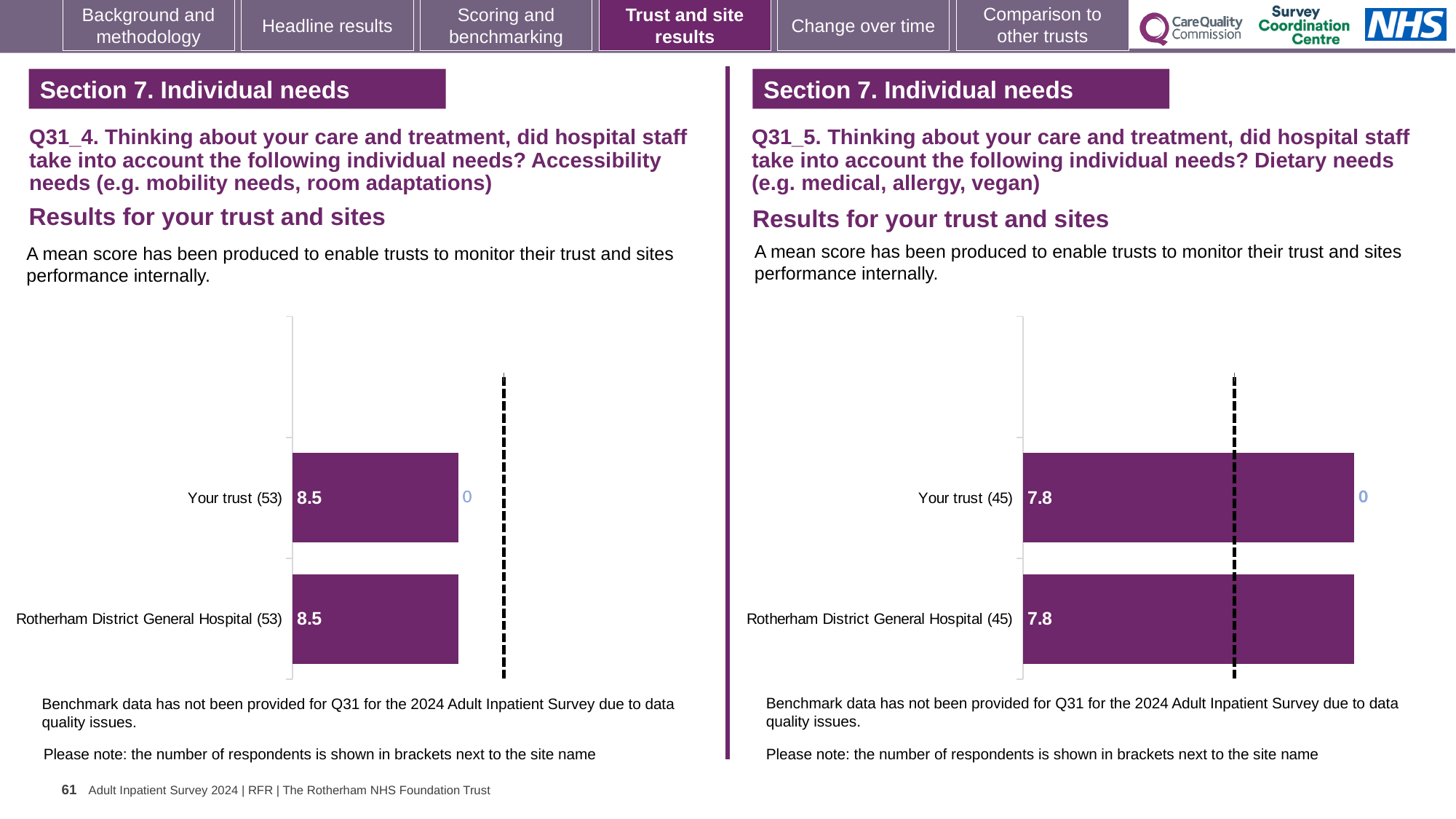
Is the score for Your trust in the right chart (Q31_5, Dietary needs) higher or lower than the score for Your trust in the left chart (Q31_4, Accessibility needs)? Lower How many bars are plotted in the right chart (Q31_5, Dietary needs)? 2 In the left chart (Q31_4, Accessibility needs), what is the mean score for Rotherham District General Hospital? 8.5 How many bars are plotted in the left chart (Q31_4, Accessibility needs)? 2 In the left chart (Q31_4, Accessibility needs), what is the mean score for Your trust? 8.5 In the left chart (Q31_4, Accessibility needs), what is the difference between the score for Your trust and the score for Rotherham District General Hospital? 0 In the right chart (Q31_5, Dietary needs), how many respondents are shown in brackets for Rotherham District General Hospital? 45 What kind of chart is used in the left chart (Q31_4, Accessibility needs)? Bar chart In the left chart (Q31_4, Accessibility needs), how many respondents are shown in brackets for Your trust? 53 In the right chart (Q31_5, Dietary needs), what is the difference between the score for Your trust and the score for Rotherham District General Hospital? 0 In the right chart (Q31_5, Dietary needs), what is the mean score for Rotherham District General Hospital? 7.8 In the right chart (Q31_5, Dietary needs), what is the mean score for Your trust? 7.8